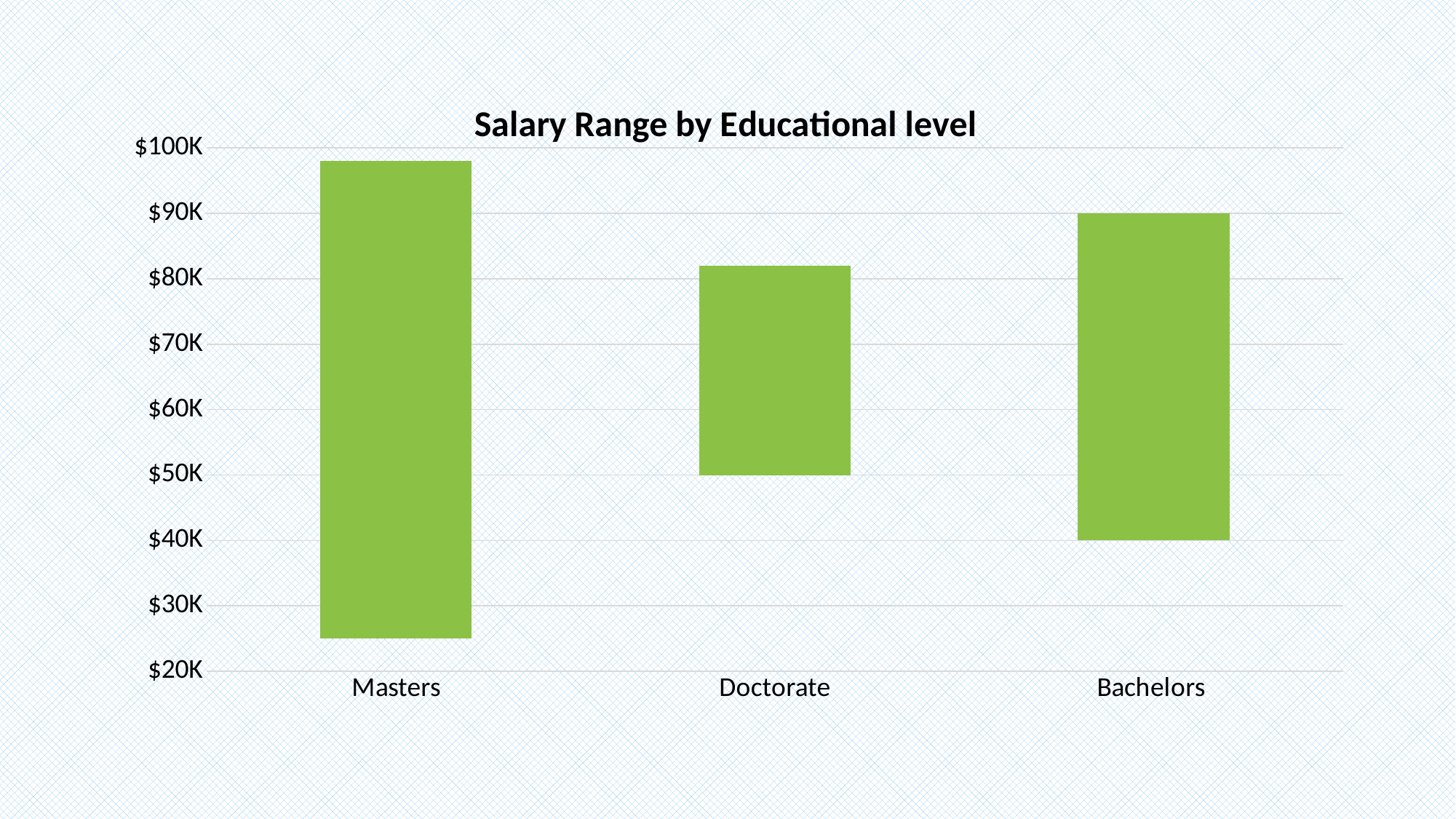
Which educational level has the highest top of its salary range? Masters What is the bottom of the salary range for Bachelors? $40K Which educational level has the narrowest salary range? Doctorate How many educational levels are shown on the x axis? 3 Is the bottom of the salary range for Masters greater or less than $30K? less Which educational level has the widest salary range? Masters Is the top of the salary range for Doctorate greater or less than $80K? greater What is the bottom of the salary range for Doctorate? $50K Is the top of the salary range for Masters greater or less than $90K? greater What kind of chart is shown on the slide? bar chart What is the top of the salary range for Bachelors? $90K What is the title of the chart? Salary Range by Educational level